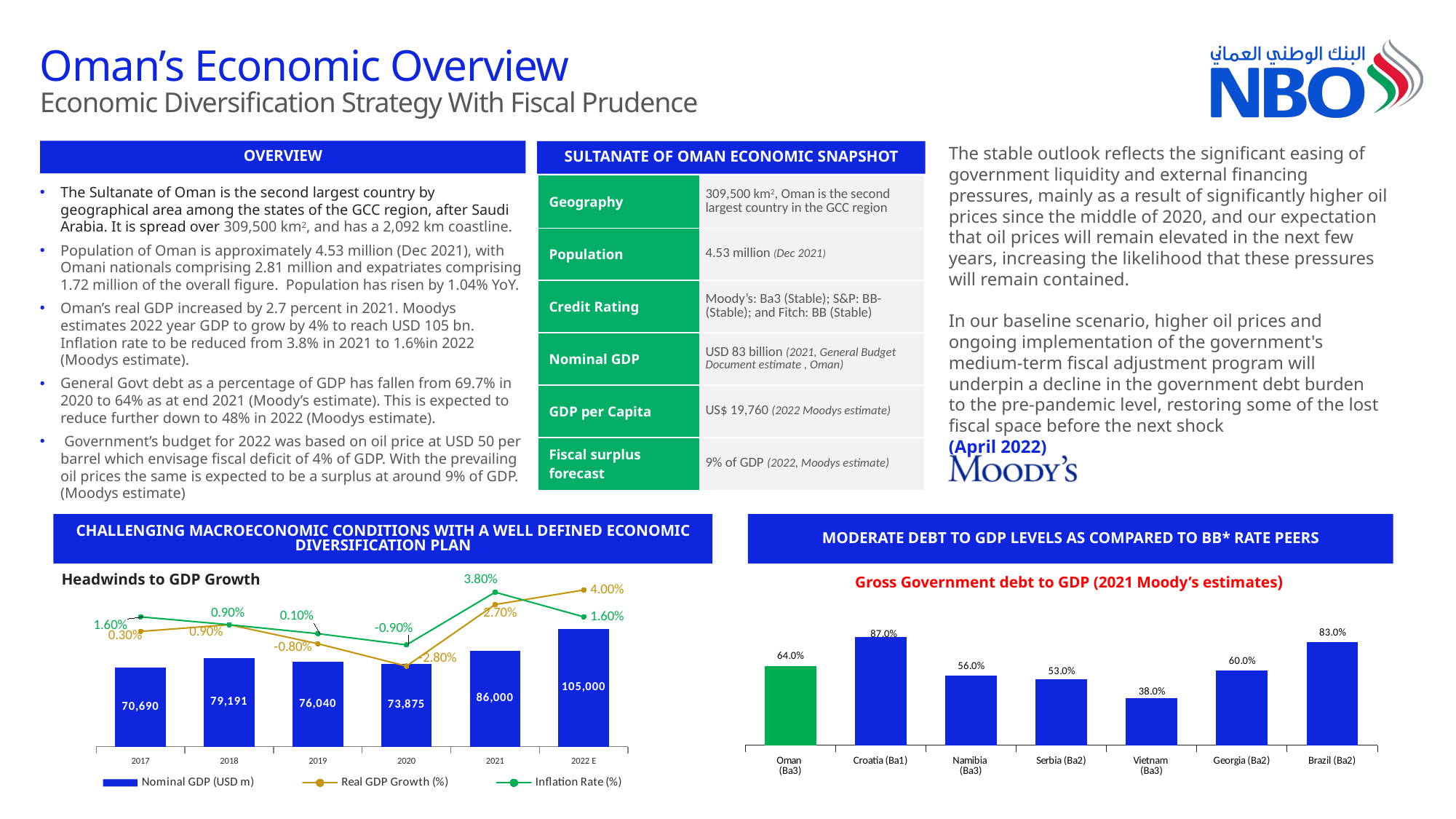
In the 'Headwinds to GDP Growth' chart, what is the Nominal GDP (USD m) value for 2021? 86,000 In the 'Headwinds to GDP Growth' chart, what is the difference in Nominal GDP (USD m) between 2022 E and 2021? 19,000 In the 'Gross Government debt to GDP' chart, what is the difference between Brazil (Ba2) and Oman (Ba3)? 19.0% In the 'Gross Government debt to GDP' chart, which country has the lowest debt to GDP? Vietnam (Ba3) In the 'Headwinds to GDP Growth' chart, which year has the lowest Nominal GDP (USD m)? 2017 In the 'Gross Government debt to GDP' chart, what is the value for Vietnam (Ba3)? 38.0% In the 'Gross Government debt to GDP' chart, which country has the highest debt to GDP? Croatia (Ba1) In the 'Headwinds to GDP Growth' chart, what is the Inflation Rate (%) value for 2021? 3.80% In the 'Headwinds to GDP Growth' chart, what is the Real GDP Growth (%) value for 2020? -2.80% What type of chart is the 'Gross Government debt to GDP' chart? Bar chart In the 'Headwinds to GDP Growth' chart, how many years are shown on the x axis? 6 How many series does the legend of the 'Headwinds to GDP Growth' chart list? 3